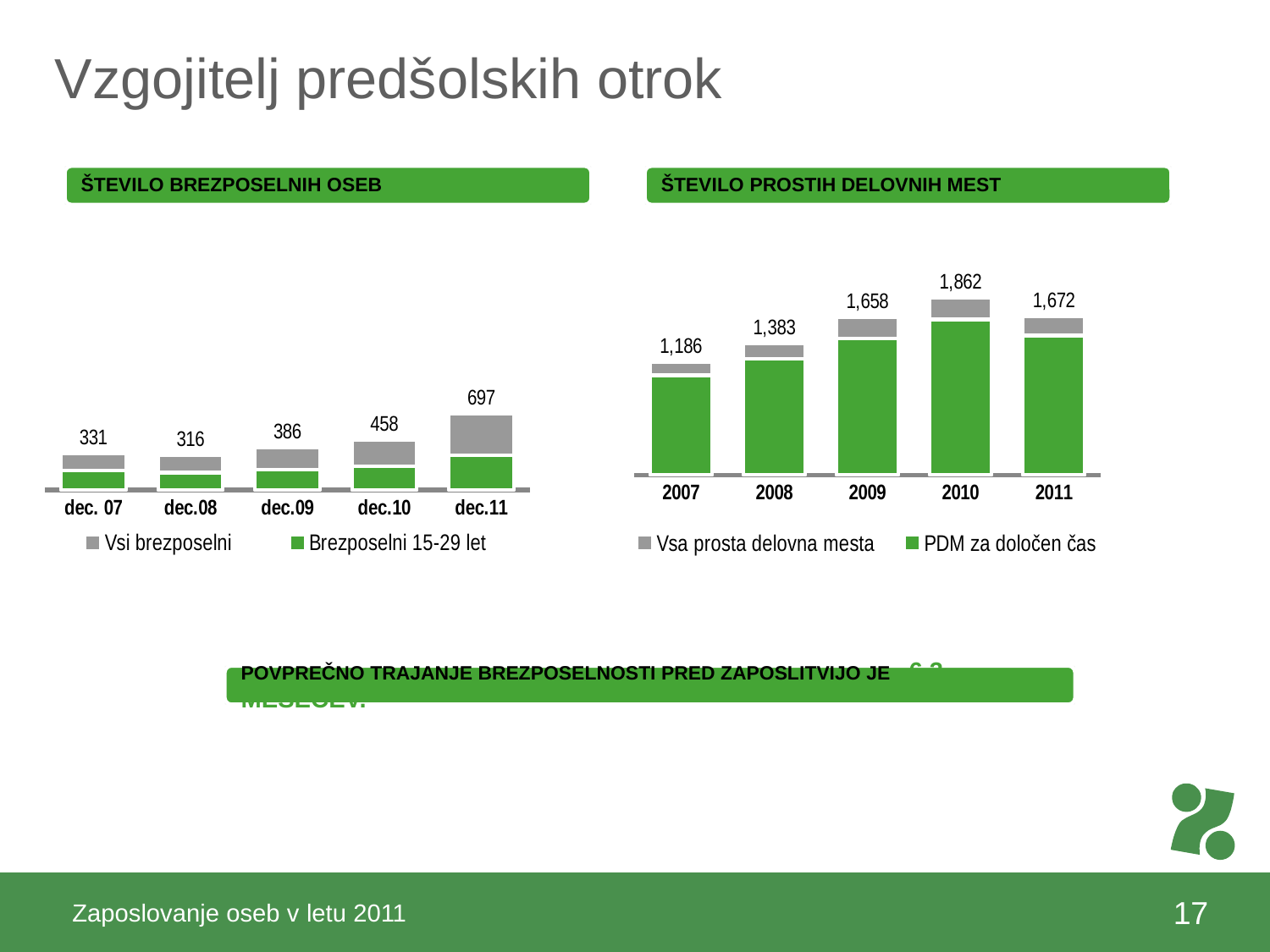
In the ŠTEVILO BREZPOSELNIH OSEB chart, what value is labelled for dec.11? 697 How many periods are shown on the x axis of the ŠTEVILO BREZPOSELNIH OSEB chart? 5 What type of chart is the ŠTEVILO BREZPOSELNIH OSEB chart? Bar chart In the ŠTEVILO BREZPOSELNIH OSEB chart, what is the difference between the labelled values for dec.11 and dec.10? 239 How many series does the legend of the ŠTEVILO PROSTIH DELOVNIH MEST chart list? 2 In the ŠTEVILO PROSTIH DELOVNIH MEST chart, what value is labelled for 2010? 1,862 In the ŠTEVILO PROSTIH DELOVNIH MEST chart, what is the difference between the labelled values for 2010 and 2011? 190 In the ŠTEVILO PROSTIH DELOVNIH MEST chart, which year has the larger labelled value, 2009 or 2011? 2011 In the ŠTEVILO BREZPOSELNIH OSEB chart, which period has the highest labelled value? dec.11 In the ŠTEVILO PROSTIH DELOVNIH MEST chart, which year has the lowest labelled value? 2007 In the ŠTEVILO PROSTIH DELOVNIH MEST chart, which year has the highest labelled value? 2010 In the ŠTEVILO BREZPOSELNIH OSEB chart, which period has the lowest labelled value? dec.08